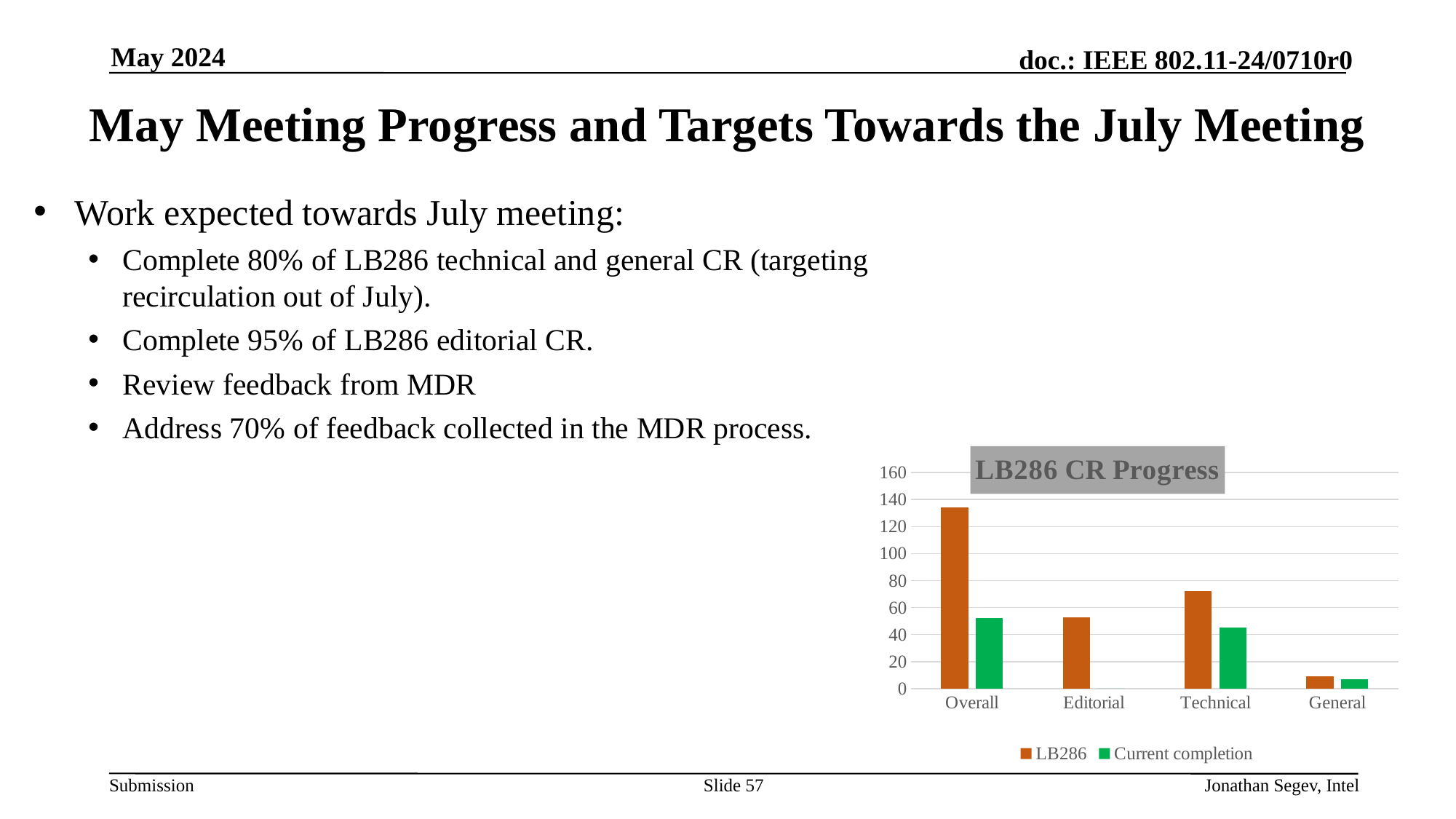
Which category has the lowest LB286 value? General Which is larger, the LB286 value for Technical or the LB286 value for Editorial? Technical Which category has the highest LB286 value? Overall Is the LB286 value for General greater or less than 20? less How many categories are shown on the x axis of the chart? 4 How many series does the chart's legend list? 2 Which colour represents the LB286 series in the chart? orange Is the LB286 value for Overall greater or less than 120? greater What is the title of the chart? LB286 CR Progress Is the Current completion value for Overall greater or less than 60? less What type of chart is shown on the slide? bar chart